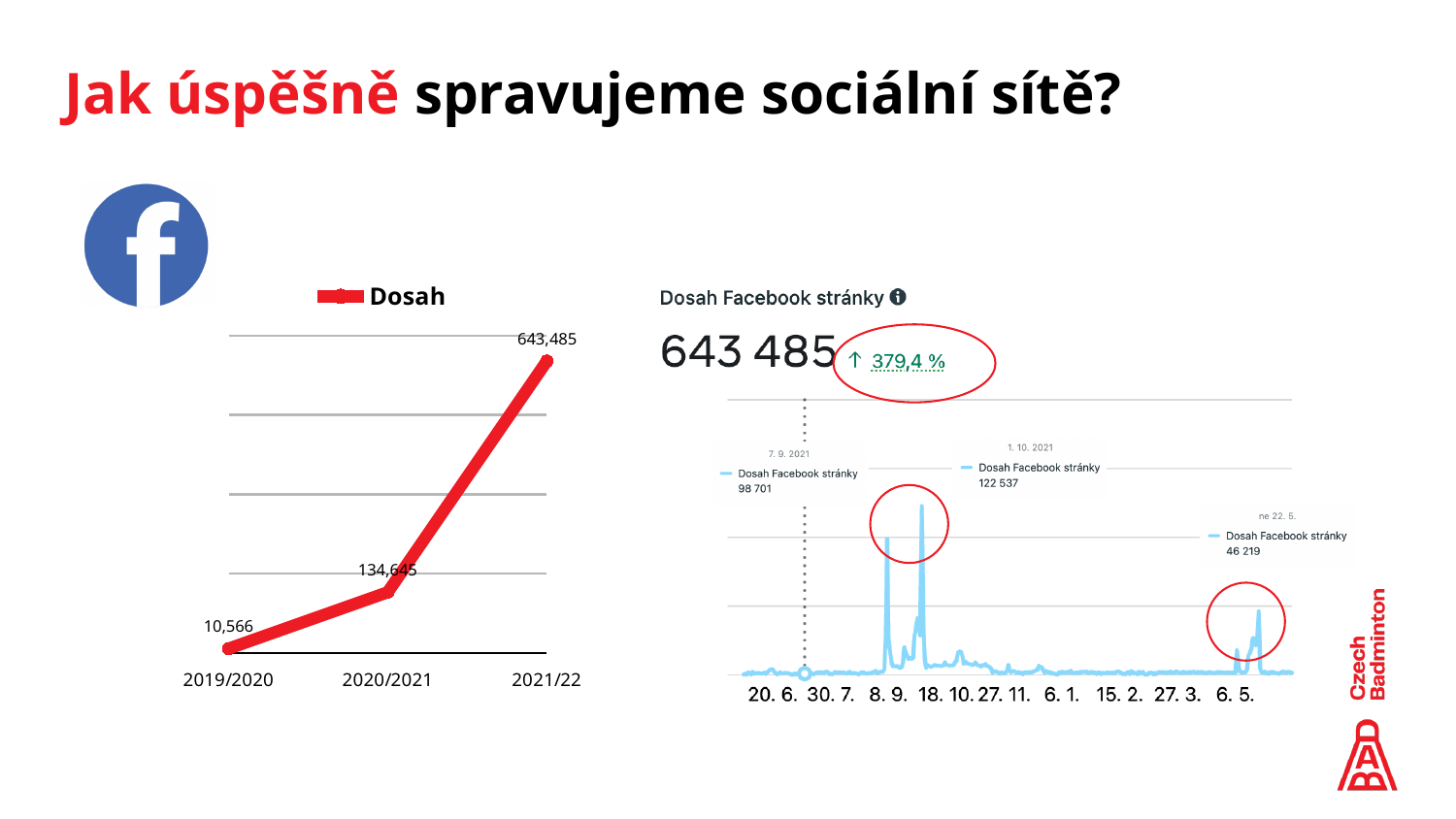
In the left line chart (Dosah), what is the difference between the 2021/22 and 2020/2021 values? 508,840 In the left line chart (Dosah), which season has the lowest value? 2019/2020 In the right chart (Dosah Facebook stránky), what is the value annotated for 1. 10. 2021? 122 537 What type of chart is the left chart titled Dosah? line chart In the left line chart (Dosah), which season has the highest value? 2021/22 In the left line chart (Dosah), what is the value for 2020/2021? 134,645 In the left line chart (Dosah), do the values rise or fall from 2019/2020 to 2021/22? rise How many data points are plotted in the left line chart (Dosah)? 3 In the right chart (Dosah Facebook stránky), what is the value annotated for 7. 9. 2021? 98 701 In the right chart (Dosah Facebook stránky), what percentage increase is shown next to the total 643 485? 379,4 % In the left line chart (Dosah), what is the value for 2019/2020? 10,566 In the left line chart (Dosah), what is the value for 2021/22? 643,485